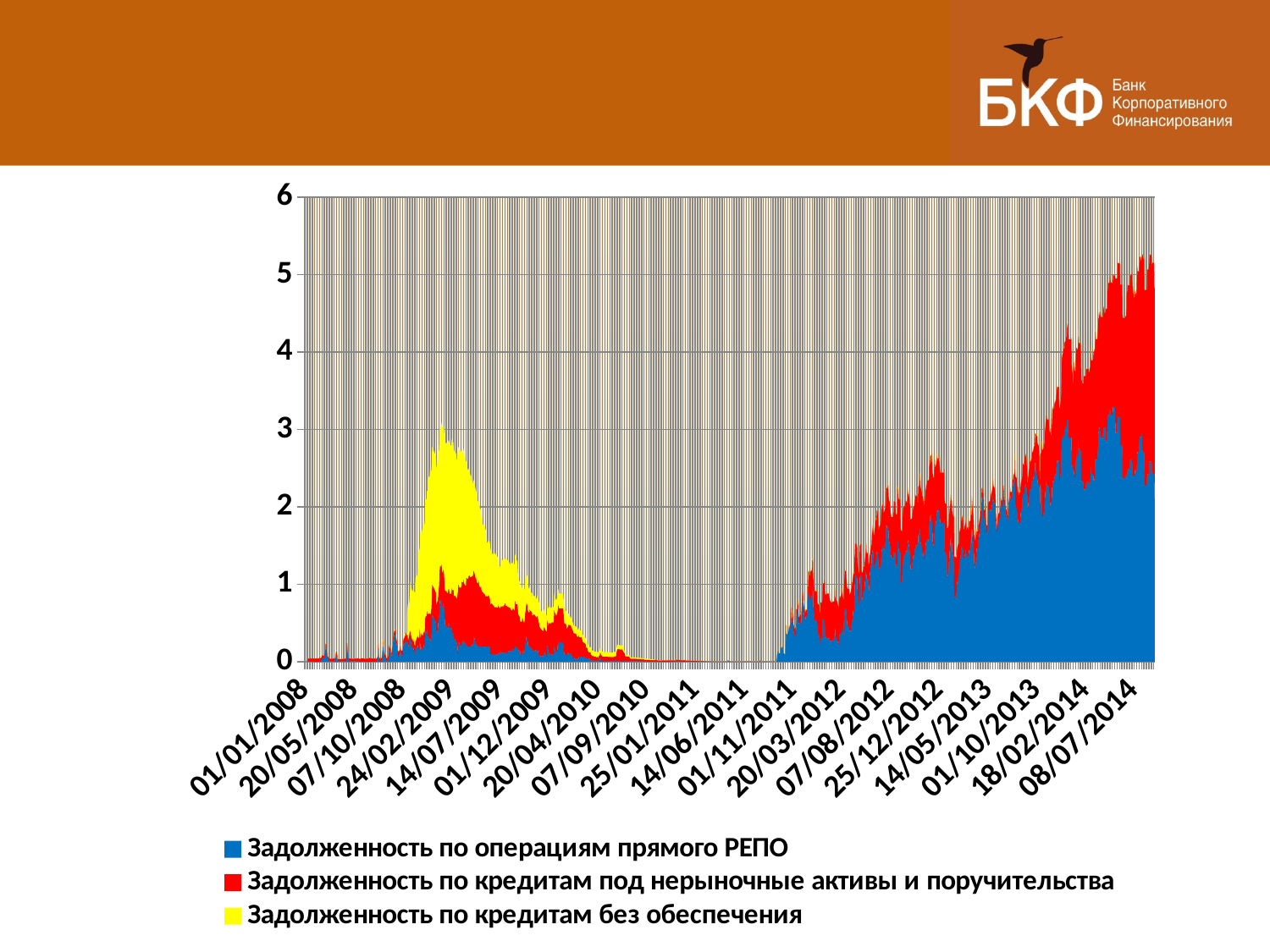
What is the last date label on the horizontal axis? 08/07/2014 Which series accounts for most of the stacked total around early 2009? Задолженность по кредитам без обеспечения Which colour represents 'Задолженность по операциям прямого РЕПО'? Blue What is the first date label on the horizontal axis? 01/01/2008 What is the highest value shown on the vertical axis? 6 How many date labels are shown on the horizontal axis? 18 Does the total stacked value rise or fall from 01/11/2011 to 08/07/2014? Rises What kind of chart is shown on the slide? Stacked area chart Which series is shown in yellow in the legend? Задолженность по кредитам без обеспечения How many series does the chart legend list? 3 Is the total stacked value near 08/07/2014 greater or less than 4? greater Is the total stacked value near 25/01/2011 greater or less than 1? less